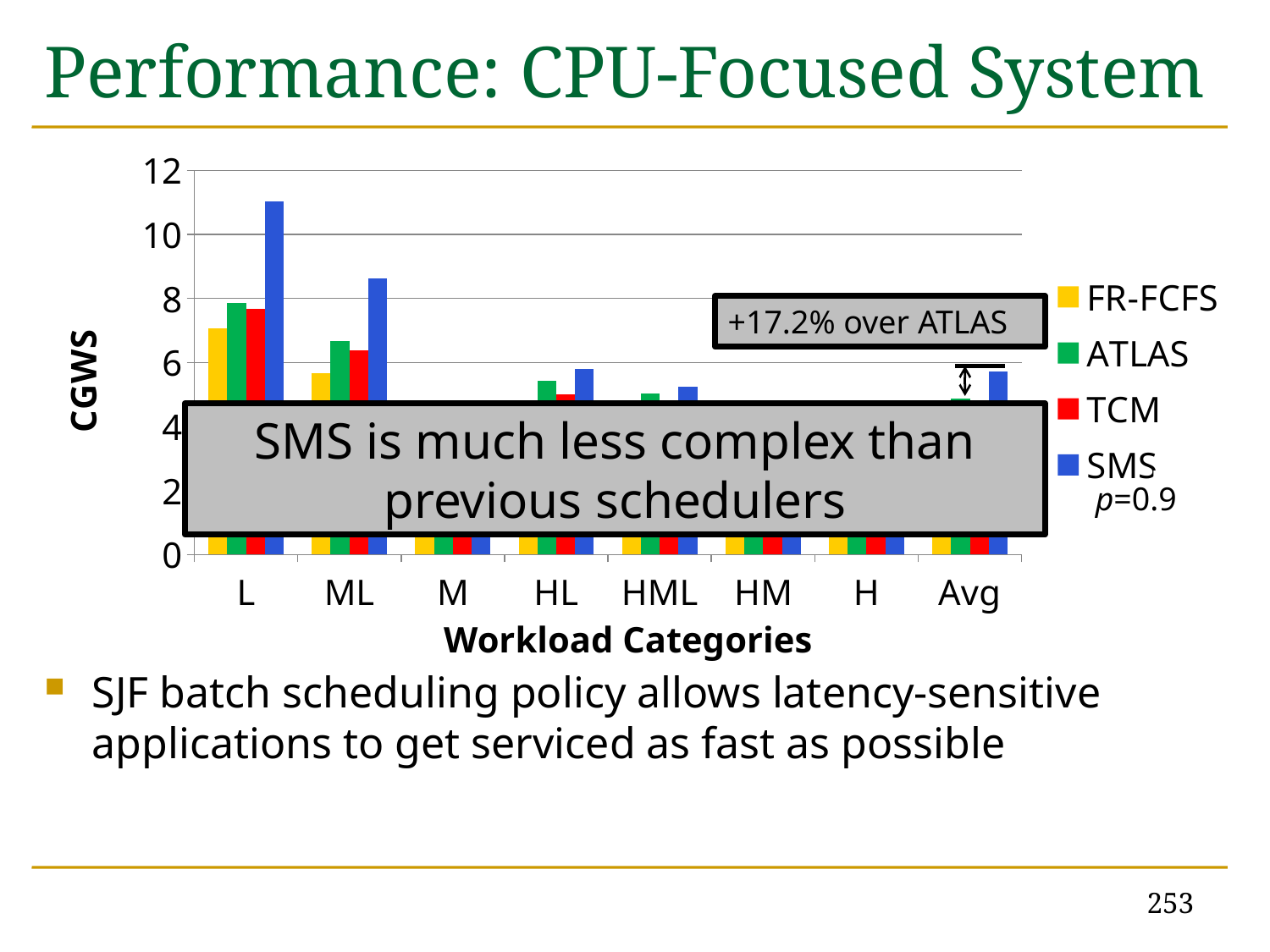
Is the FR-FCFS value for workload category L greater or less than 8? less How many series does the legend list? 4 Which series has the highest value for workload category ML? SMS Is the SMS value for workload category L greater or less than 10? greater Is the SMS value for workload category ML greater or less than 8? greater What kind of chart is shown on the slide? bar chart For workload category L, which is larger: the SMS value or the FR-FCFS value? SMS What improvement over ATLAS does the annotation on the chart state? +17.2% over ATLAS For workload category ML, which is larger: the SMS value or the TCM value? SMS How many workload categories are shown on the x axis? 8 Which series has the highest value for workload category L? SMS What is the label of the y axis? CGWS